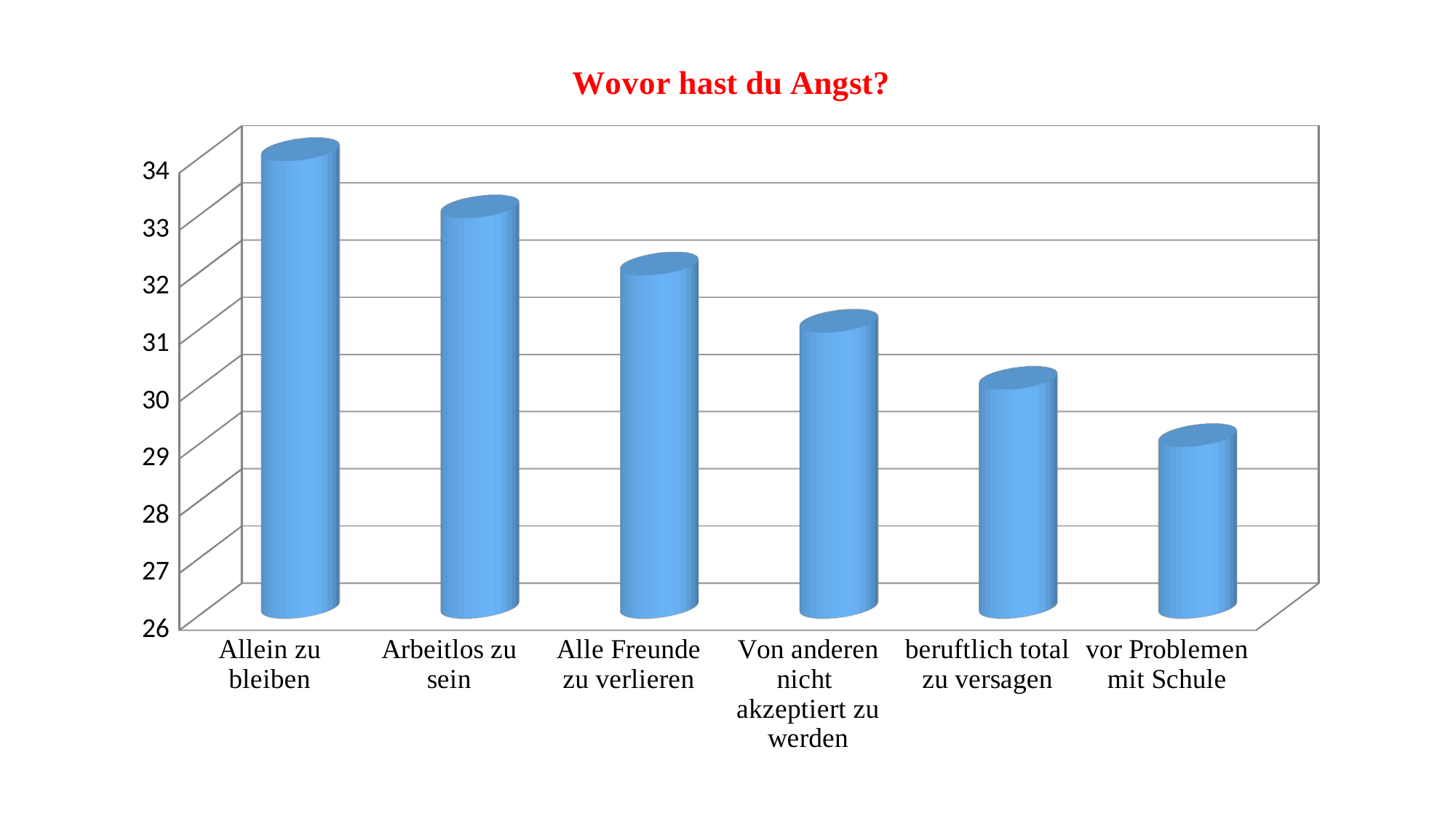
What colour are the bars in the chart? blue Is the value for 'Allein zu bleiben' greater or less than 33? greater How many categories are shown on the x axis of the chart? 6 Which category has the lowest value in the chart? vor Problemen mit Schule Which is larger: the value for 'Arbeitlos zu sein' or the value for 'Alle Freunde zu verlieren'? Arbeitlos zu sein Which category has the highest value in the chart? Allein zu bleiben Which is larger: the value for 'beruftlich total zu versagen' or the value for 'vor Problemen mit Schule'? beruftlich total zu versagen Is the value for 'vor Problemen mit Schule' greater or less than 30? less What kind of chart is shown on the slide? bar chart Is the value for 'Von anderen nicht akzeptiert zu werden' greater or less than 32? less What is the title of the chart? Wovor hast du Angst? Do the values rise or fall from left to right along the x axis? fall